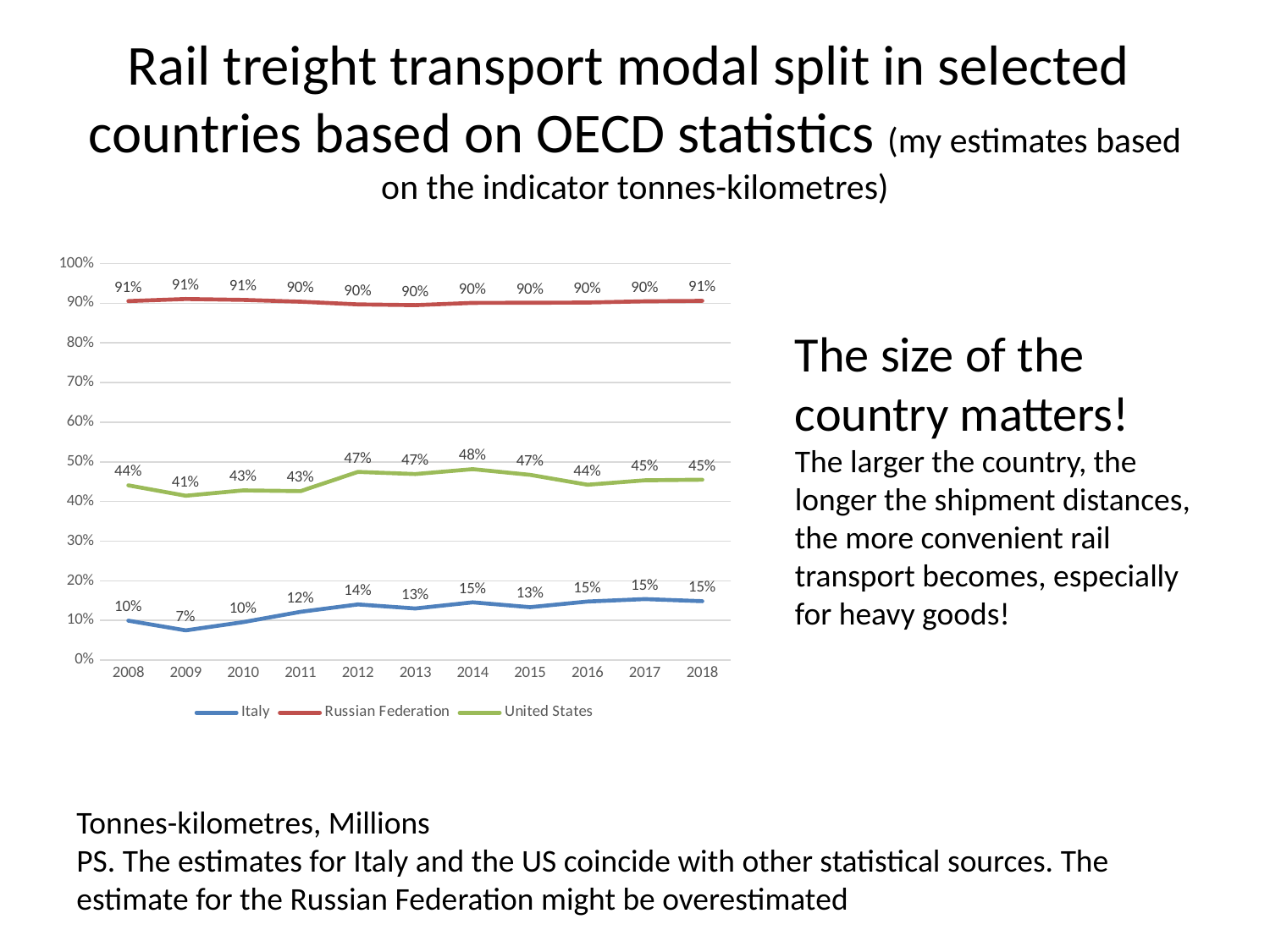
Does the value for Italy rise or fall from 2008 to 2018? rise What kind of chart is shown on the slide? line chart In which year is the value for Italy lowest? 2009 Is the value for the Russian Federation in 2013 greater or less than 80%? greater How many series does the legend list? 3 Which series has the larger value in 2016, Italy or the United States? United States How many years are plotted along the x axis? 11 What is the value for the Russian Federation in 2018? 91% What is the difference between the United States and Italy values in 2012? 33% What is the value for the United States in 2014? 48% What is the value for Italy in 2009? 7% In which year is the value for the United States highest? 2014